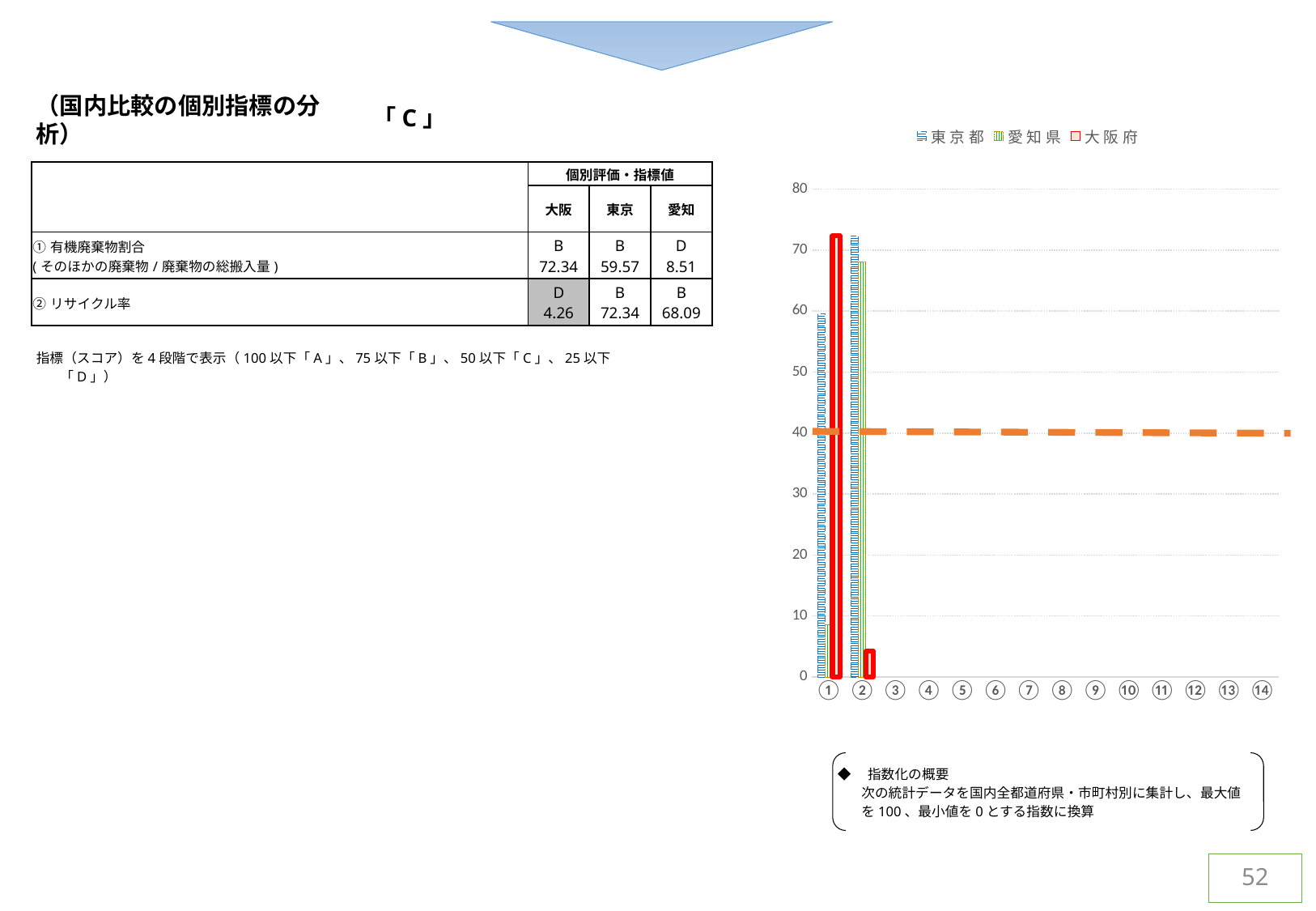
Is the value for 愛知県 at category ② greater or less than 60? greater Is the value for 大阪府 at category ② greater or less than 10? less How many series does the chart legend list? 3 At category ②, which series has the larger value, 東京都 or 大阪府? 東京都 What kind of chart is shown on the right side of the slide? bar chart Is the value for 愛知県 at category ① greater or less than 20? less At what value on the y axis is the horizontal dashed line drawn across the chart? 40 Which series has the highest value at category ①? 大阪府 How many categories are shown along the x axis of the chart? 14 At category ①, which series has the larger value, 大阪府 or 愛知県? 大阪府